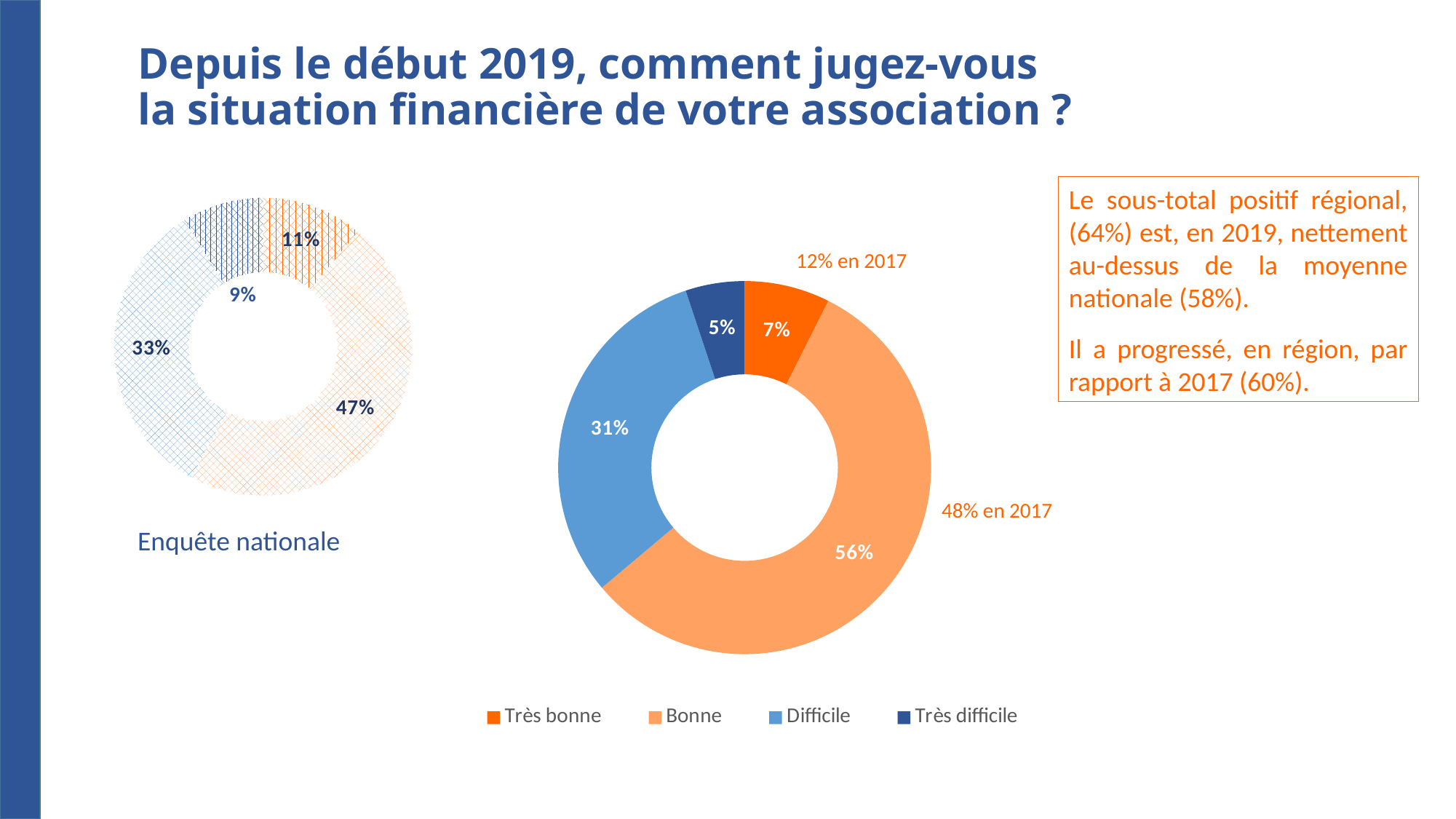
In the large donut chart on the right, what is the difference between the shares for "Bonne" and "Difficile"? 25% What type of chart is the large chart on the right? Donut chart In the large donut chart on the right, what share of respondents answered "Très bonne"? 7% In the large donut chart on the right, what share of respondents answered "Très difficile"? 5% How many categories does the legend of the large donut chart on the right list? 4 According to the annotation on the large donut chart on the right, what was the share for "Très bonne" in 2017? 12% In the large donut chart on the right, what share of respondents answered "Bonne"? 56% In the large donut chart on the right, which is larger: the share for "Très bonne" or the share for "Très difficile"? Très bonne In the large donut chart on the right, which category has the smallest share? Très difficile In the "Enquête nationale" donut chart on the left, what is the largest share shown? 47% In the large donut chart on the right, what share of respondents answered "Difficile"? 31% In the large donut chart on the right, which category has the largest share? Bonne